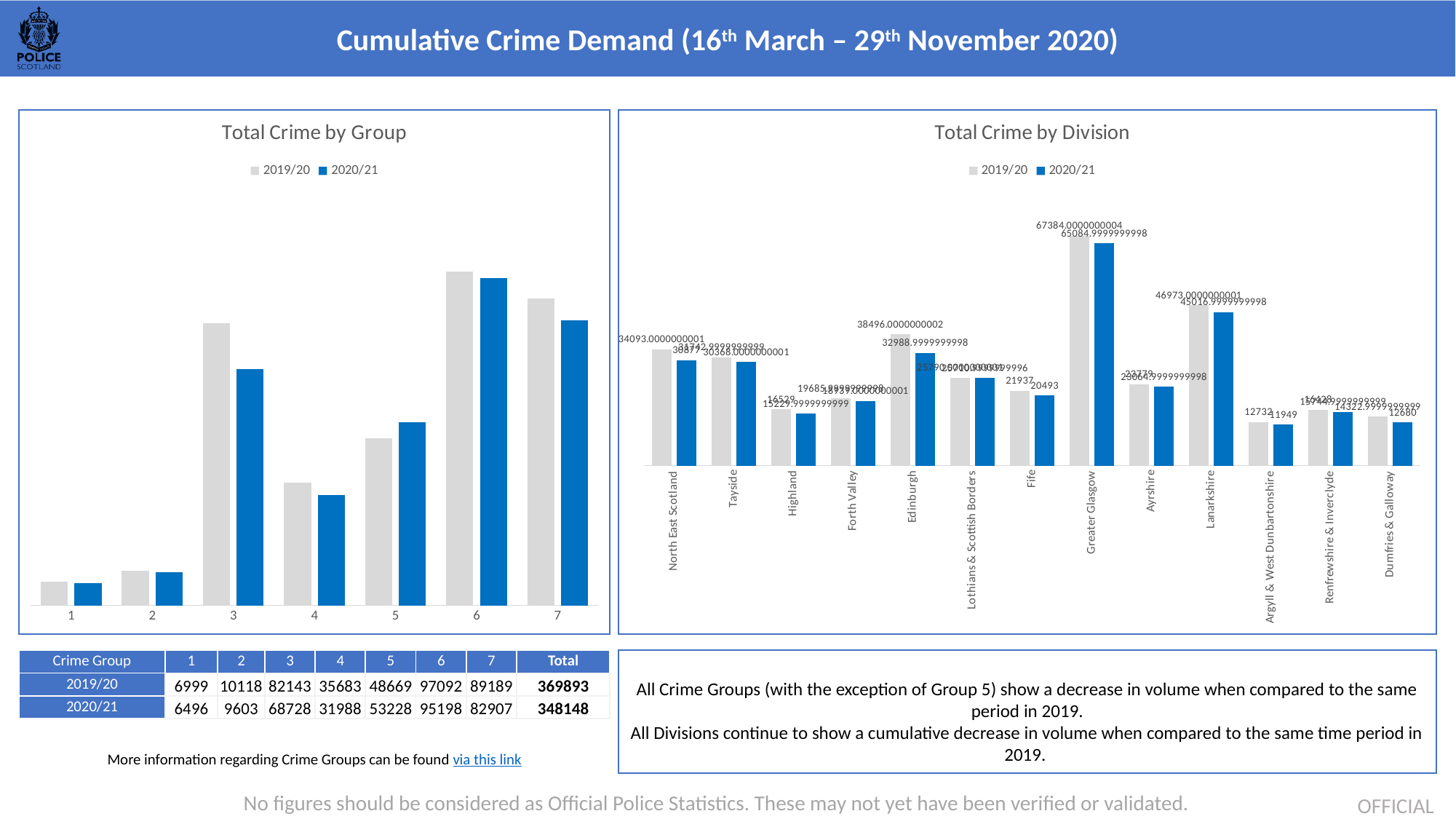
In the "Total Crime by Division" chart, what is the 2019/20 value for Argyll & West Dunbartonshire? 12732 In the "Total Crime by Division" chart, how many divisions are shown on the x axis? 13 In the "Total Crime by Group" chart, how many crime groups are shown on the x axis? 7 In the "Total Crime by Division" chart, what is the difference between the 2019/20 and 2020/21 values for Fife? 1444 In the "Total Crime by Division" chart, which division has the highest 2019/20 value? Greater Glasgow In the "Total Crime by Group" chart, which crime group has the highest 2019/20 bar? 6 In the "Total Crime by Division" chart, what is the 2020/21 value for Fife? 20493 In the "Total Crime by Group" chart, which crime group has the lowest 2020/21 bar? 1 In the "Total Crime by Group" chart, for group 5, which series has the larger bar, 2019/20 or 2020/21? 2020/21 In the "Total Crime by Group" chart, how many series does the legend list? 2 What kind of chart is the "Total Crime by Group" chart? bar chart In the "Total Crime by Division" chart, which division has the lowest 2019/20 value? Argyll & West Dunbartonshire